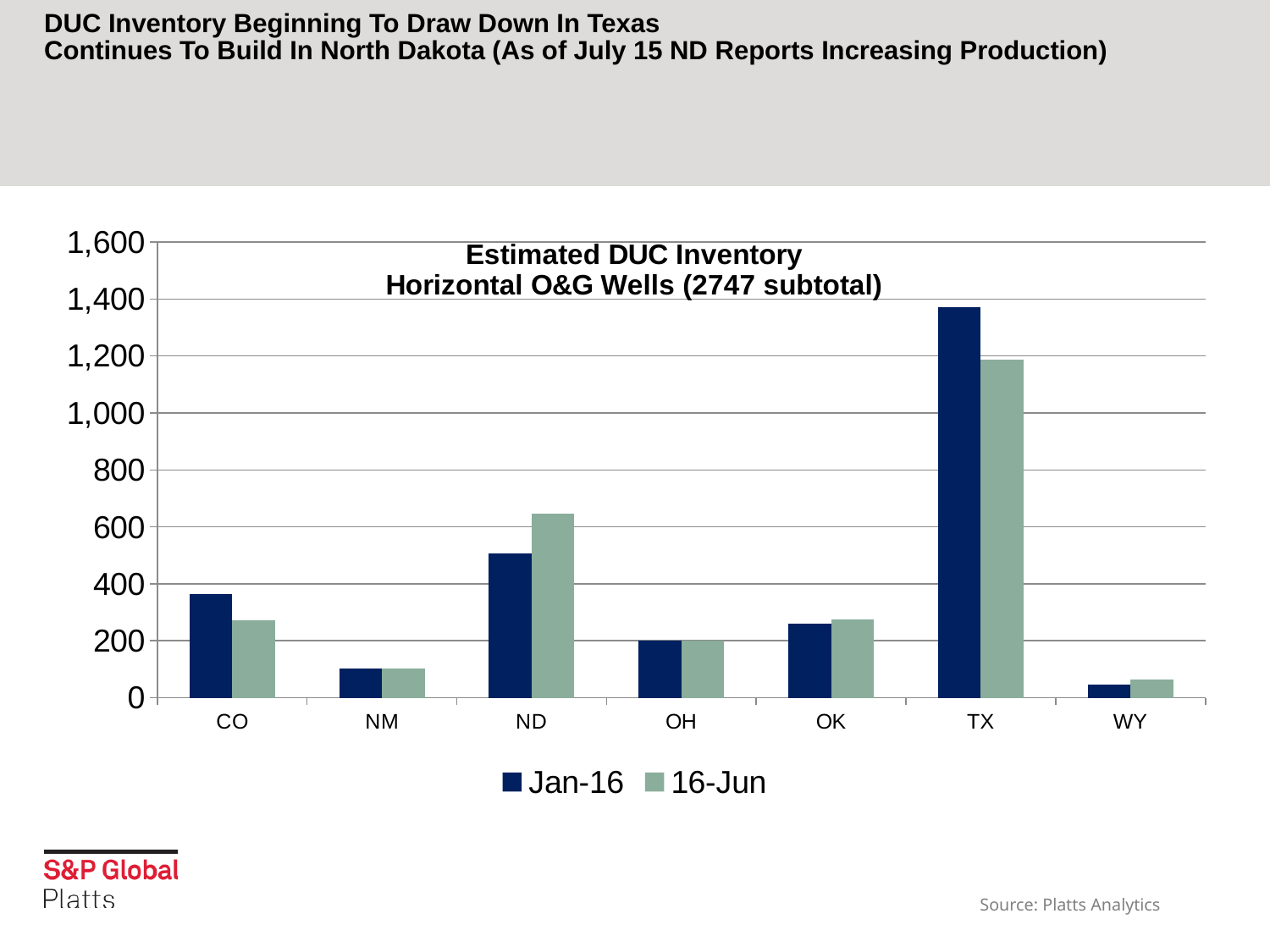
What kind of chart is shown on the slide? Bar chart How many states are shown on the x axis? 7 What are the two series named in the legend? Jan-16 and 16-Jun Which state has the highest Jan-16 value? TX How many series does the legend list? 2 Is the Jan-16 value for TX greater or less than 1,200? greater For TX, which is larger: the Jan-16 value or the 16-Jun value? Jan-16 Is the 16-Jun value for ND greater or less than 600? greater Is the 16-Jun value for WY greater or less than 200? less For ND, which is larger: the Jan-16 value or the 16-Jun value? 16-Jun Which state has the lowest Jan-16 value? WY